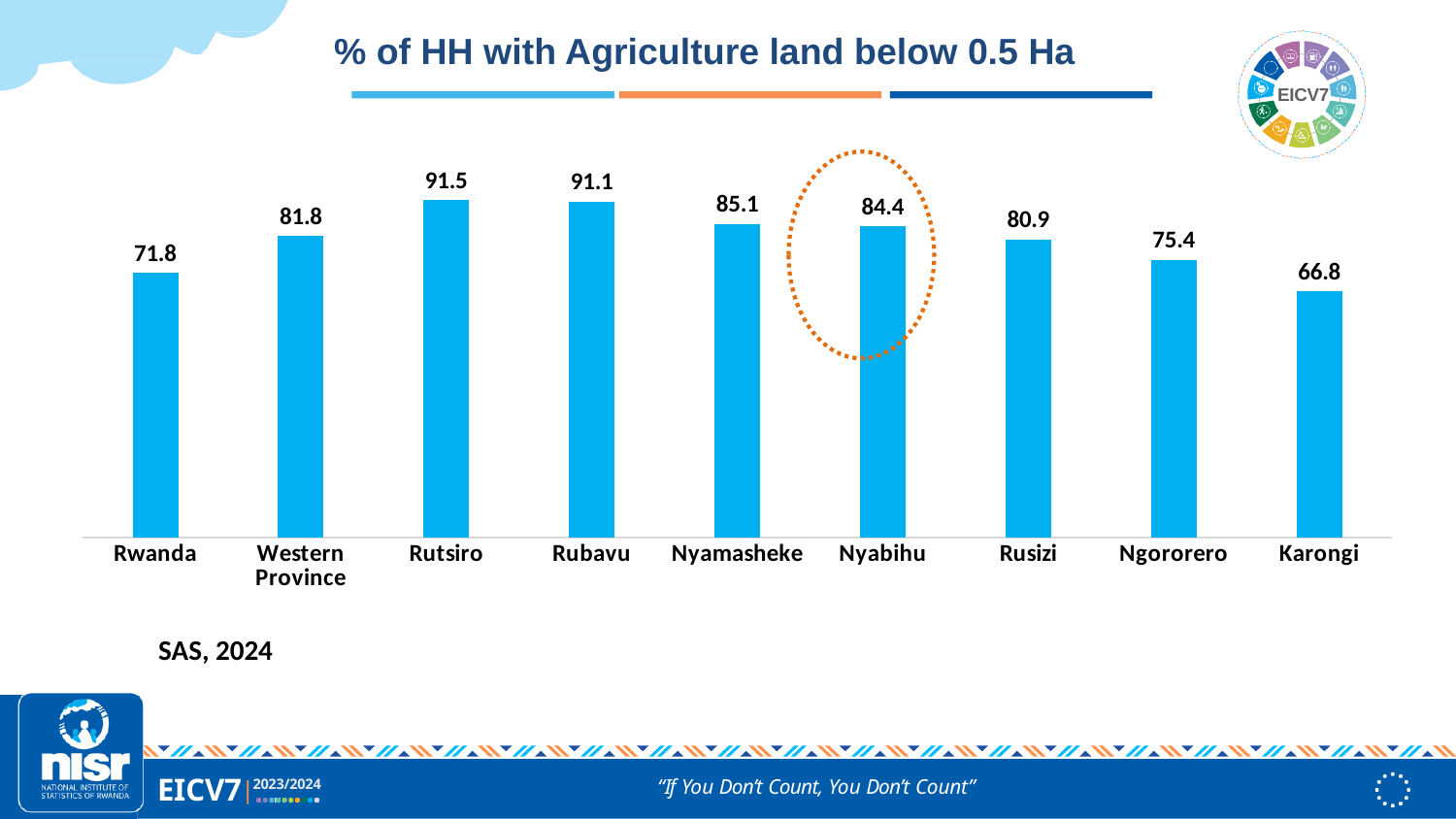
Which category has the highest value? Rutsiro What is the value for Rwanda? 71.8 Which category's bar is circled with a dotted orange outline? Nyabihu What is the value for Nyabihu? 84.4 How many categories are shown on the x axis? 9 What is the difference between the values for Rutsiro and Karongi? 24.7 Which is larger, the value for Nyamasheke or the value for Rusizi? Nyamasheke What is the difference between the values for Nyabihu and Rwanda? 12.6 What is the value for Western Province? 81.8 What kind of chart is this? Bar chart Which category has the lowest value? Karongi What is the title of the chart? % of HH with Agriculture land below 0.5 Ha